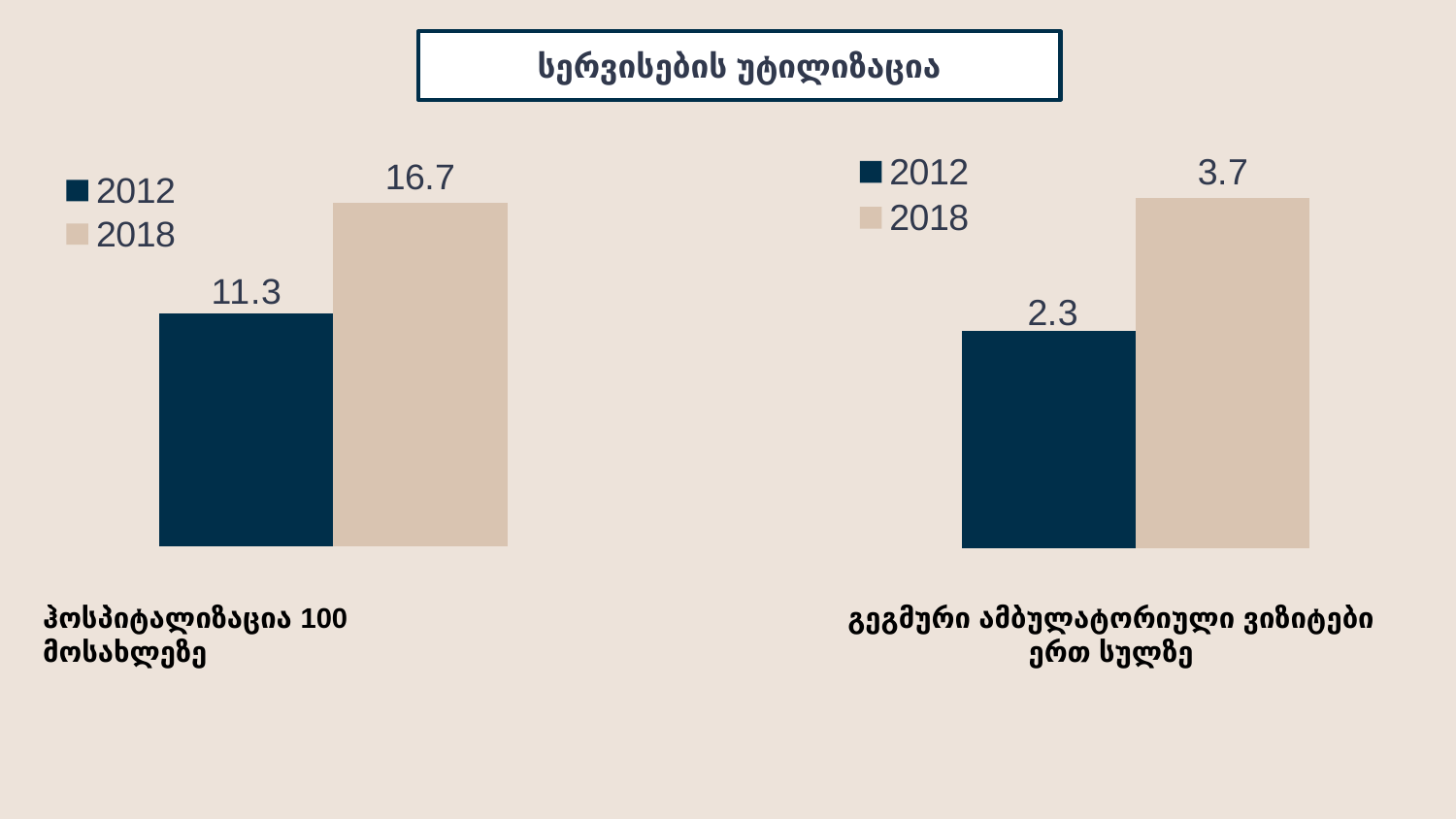
In the right chart, what is the difference between the 2018 and 2012 values? 1.4 In the right chart (გეგმური ამბულატორიული ვიზიტები ერთ სულზე), what is the value for 2018? 3.7 In the right chart (გეგმური ამბულატორიული ვიზიტები ერთ სულზე), what is the value for 2012? 2.3 In the right chart, is the value for 2018 larger or smaller than the value for 2012? larger What type of chart is the right chart? bar chart In the left chart, which year has the higher value? 2018 In the left chart, what is the difference between the 2018 and 2012 values? 5.4 In the right chart, which year has the lower value? 2012 What is the title shown at the top of the slide? სერვისების უტილიზაცია In the left chart (ჰოსპიტალიზაცია 100 მოსახლეზე), what is the value for 2012? 11.3 How many series does the legend of the left chart list? 2 In the left chart (ჰოსპიტალიზაცია 100 მოსახლეზე), what is the value for 2018? 16.7